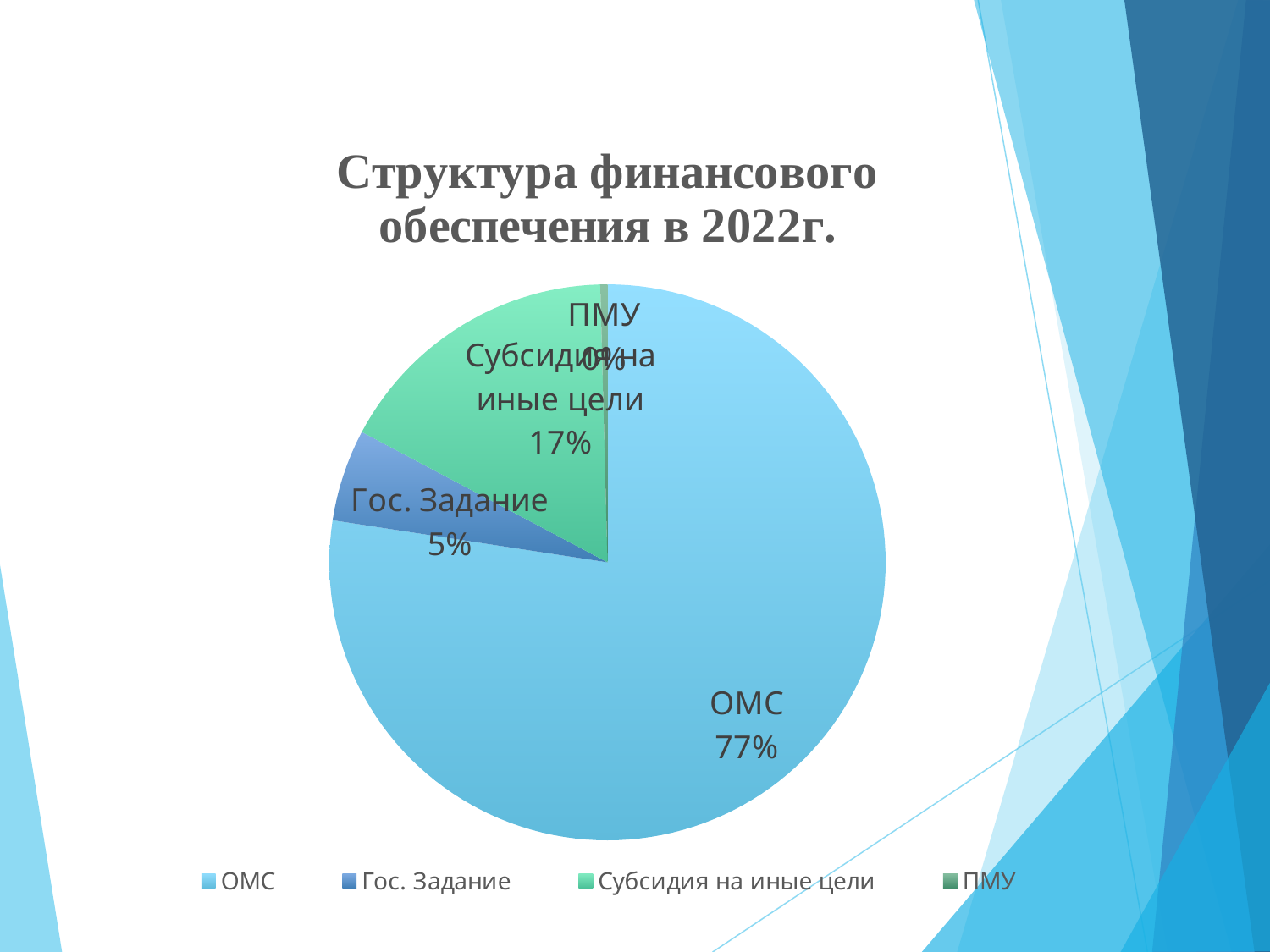
What share of the pie does Субсидия на иные цели account for? 17% What share of the pie does ОМС account for? 77% What kind of chart is shown on the slide? pie chart What is the title of the chart? Структура финансового обеспечения в 2022г. What colour is the ОМС slice in the pie chart? light blue What is the difference in percentage points between the Субсидия на иные цели share and the Гос. Задание share? 12 How many entries does the legend list? 4 What share of the pie does Гос. Задание account for? 5% Which is larger, the share for Гос. Задание or the share for Субсидия на иные цели? Субсидия на иные цели What is the difference in percentage points between the ОМС share and the Субсидия на иные цели share? 60 Which category has the largest share of the pie? ОМС Which category has the smallest share of the pie? ПМУ